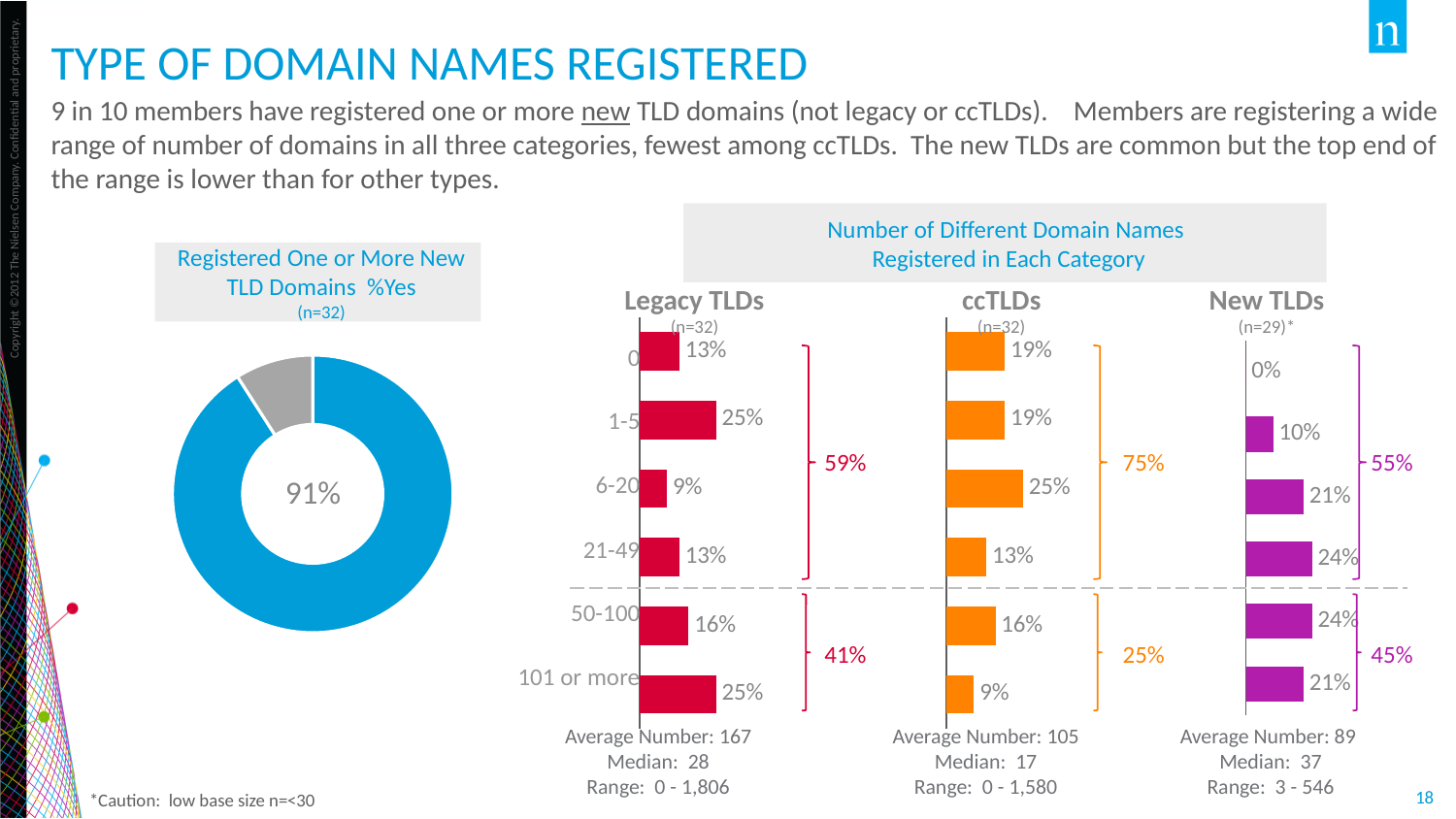
What kind of chart is used for the Legacy TLDs, ccTLDs and New TLDs data? Bar chart In the ccTLDs bar chart, what is the value for '101 or more'? 9% What kind of chart is the 'Registered One or More New TLD Domains %Yes' chart? Donut (pie) chart In the New TLDs bar chart, what is the value for the '0' category? 0% In the New TLDs bar chart, what is the difference between the '21-49' value and the '1-5' value? 14% In the Legacy TLDs bar chart, which is larger: the value for '50-100' or the value for '21-49'? 50-100 In the ccTLDs bar chart, which category has the highest value? 6-20 In the ccTLDs bar chart, what is the difference between the '6-20' value and the '21-49' value? 12% How many categories are shown in the ccTLDs bar chart? 6 In the 'Registered One or More New TLD Domains %Yes' donut chart, what percentage is shown? 91% In the Legacy TLDs bar chart, what is the value for the '1-5' category? 25% In the Legacy TLDs bar chart, which category has the lowest value? 6-20